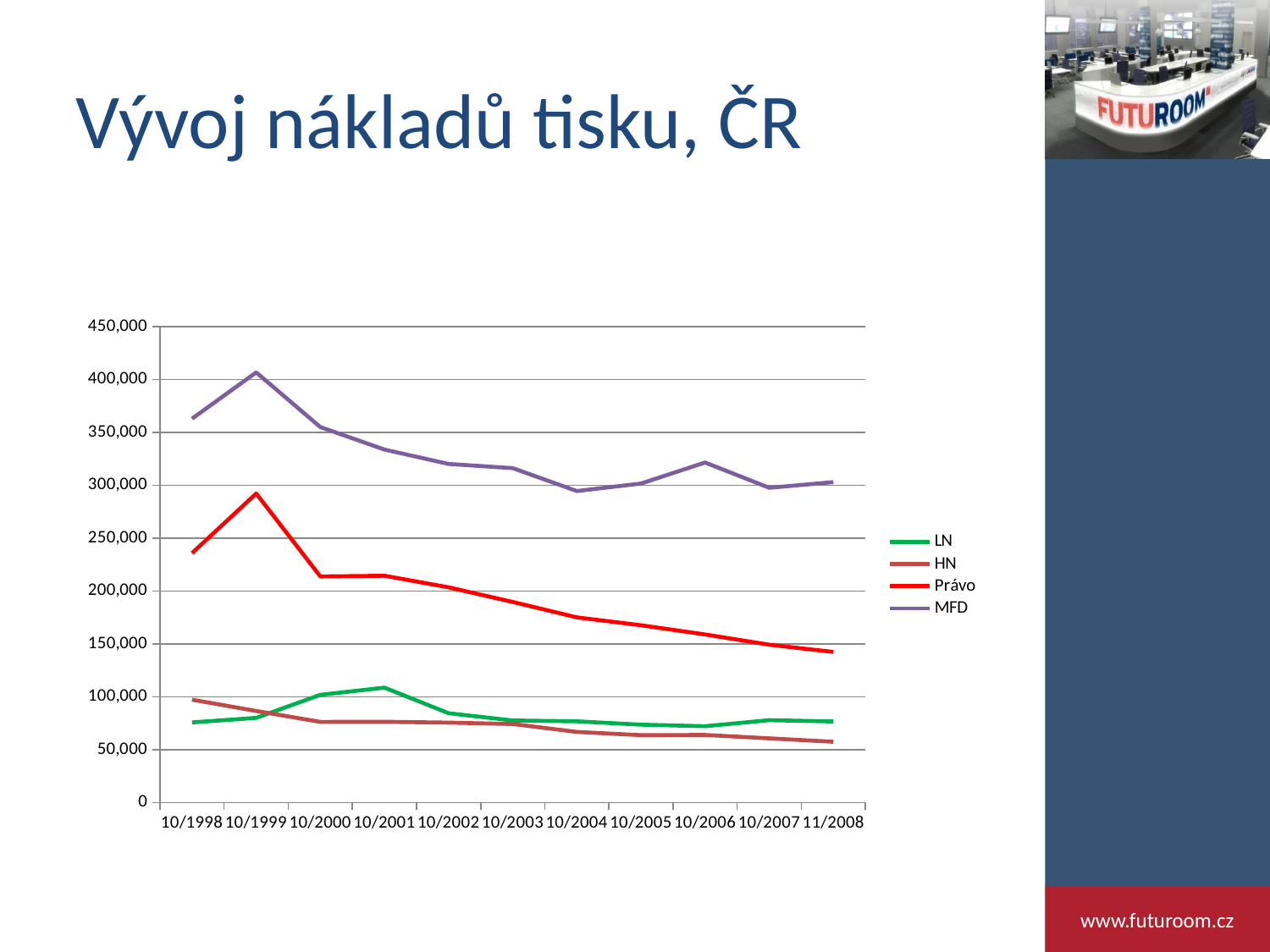
Does the Právo series rise or fall from 10/1999 to 11/2008? fall How many series does the legend list? 4 At which time point does the Právo series reach its highest value? 10/1999 Is the value for MFD at 10/1999 greater or less than 350,000? greater At 10/2001, which series has the larger value, LN or HN? LN Is the value for Právo at 11/2008 greater or less than 150,000? less What is the title of the chart on the slide? Vývoj nákladů tisku, ČR Which series has the lowest value at 11/2008? HN Which series has the highest values across the whole period? MFD What kind of chart is shown on the slide? line chart At which time point does the MFD series reach its highest value? 10/1999 How many time points are shown on the x axis? 11